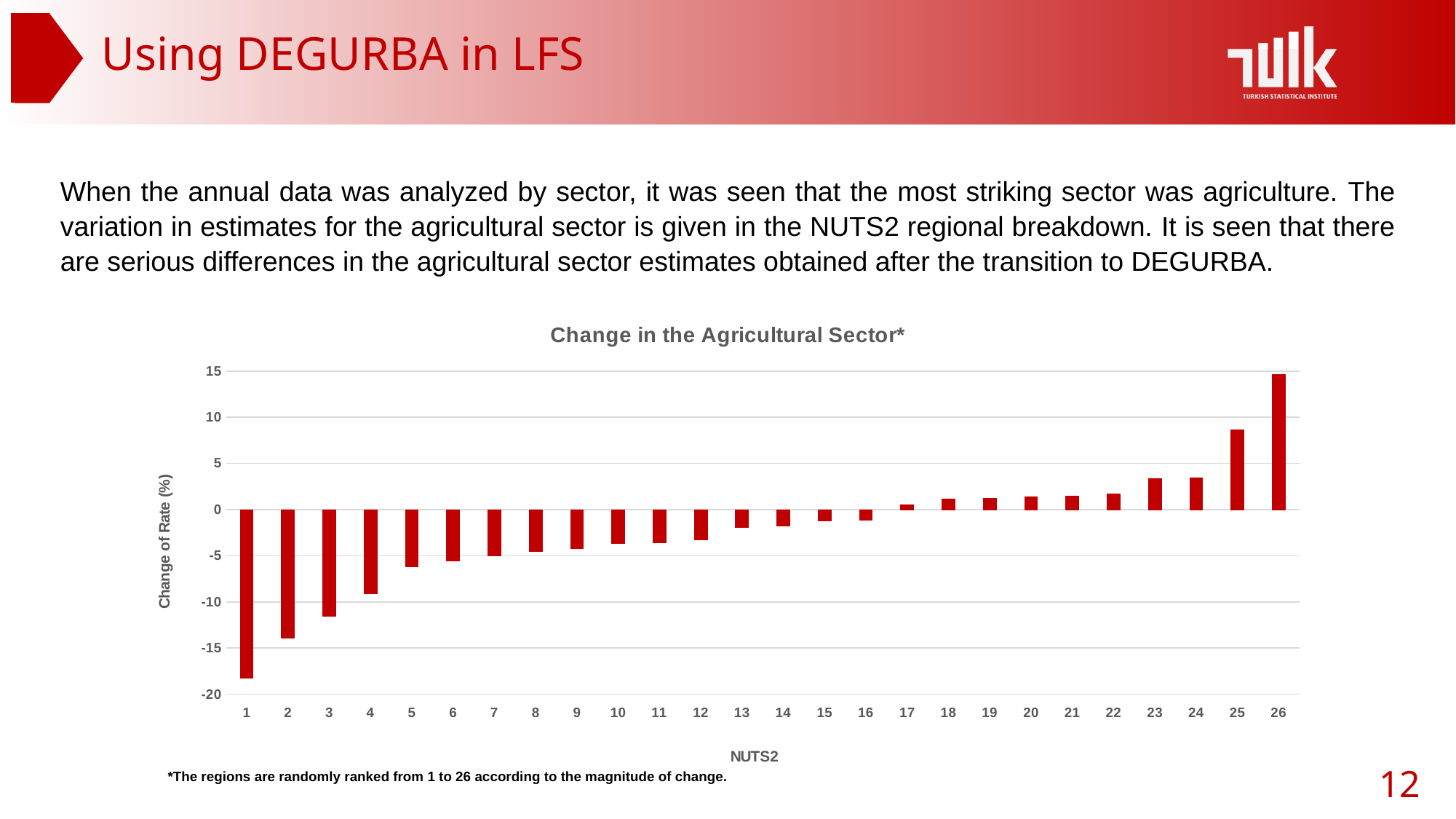
What is the title of the chart? Change in the Agricultural Sector* Is the value for region 1 greater or less than -15? less Is the value for region 4 greater or less than -10? greater How many NUTS2 regions are plotted in the chart? 26 What kind of chart is shown on the slide? Bar chart Which NUTS2 region has the highest change of rate? 26 Do the values rise or fall as you move from region 1 to region 26 along the x axis? Rise What is the label of the vertical axis of the chart? Change of Rate (%) Which has the higher change of rate, region 3 or region 5? Region 5 Which NUTS2 region has the lowest change of rate? 1 Is the value for region 26 greater or less than 10? greater